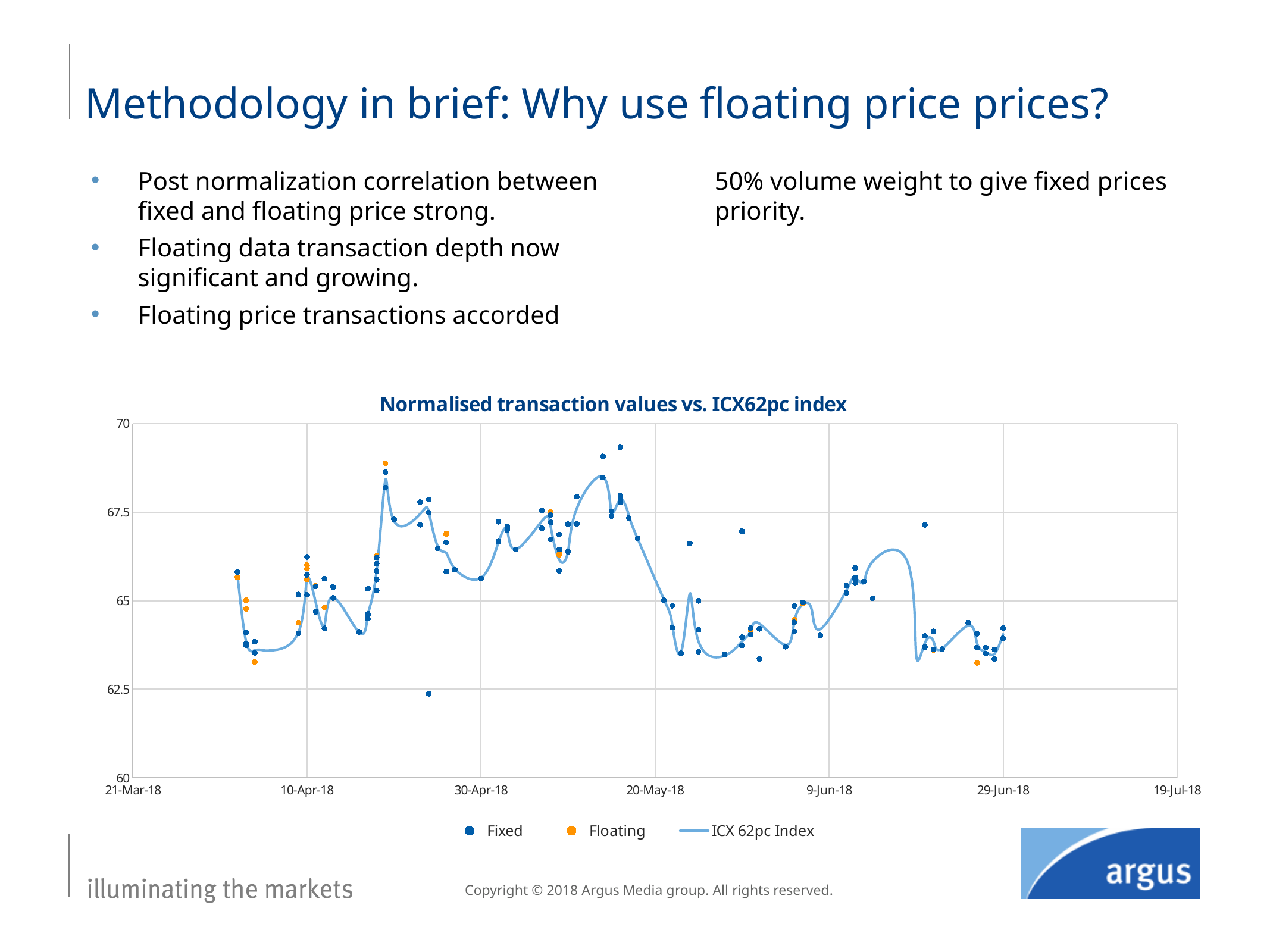
What type of chart is shown on the slide? Scatter chart with a line Does the ICX 62pc Index line rise or fall between 20-May-18 and 9-Jun-18? fall Which series is shown with orange markers in the chart? Floating Does the ICX 62pc Index line rise or fall between 10-Apr-18 and its peak before 30-Apr-18? rise How many series does the chart legend list? 3 Is the peak of the ICX 62pc Index line shortly after 10-Apr-18 greater or less than 67.5? greater What is the maximum value shown on the y axis of the chart? 70 Is the value of the ICX 62pc Index line at 30-Apr-18 greater or less than 65? greater Is the highest Fixed data point on the chart greater or less than 67.5? greater What is the title of the chart? Normalised transaction values vs. ICX62pc index How many date labels are shown on the x axis of the chart? 7